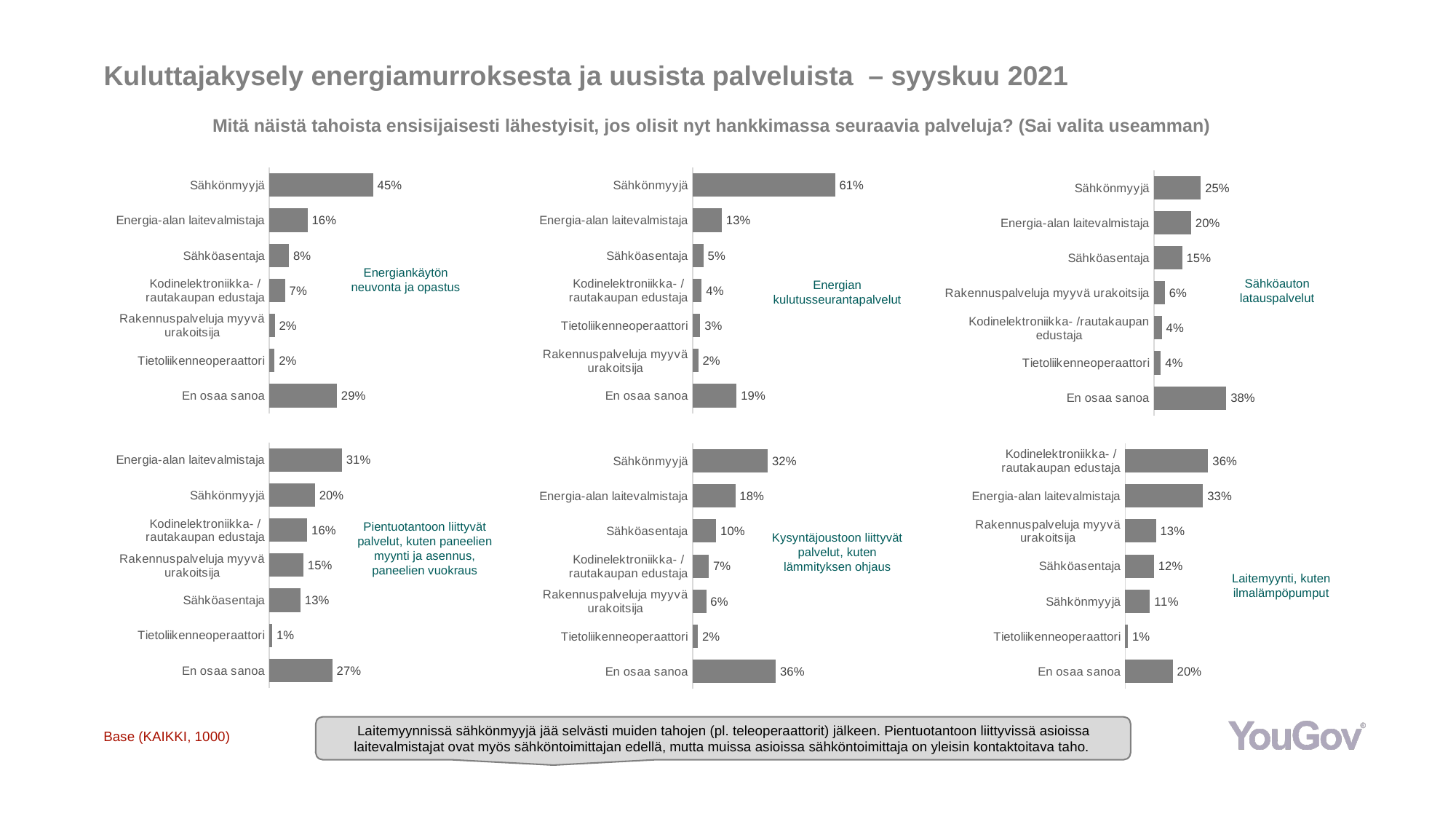
In the 'Energian kulutusseurantapalvelut' chart, which category has the highest value? Sähkönmyyjä How many bar charts are shown on the slide? 6 In the 'Energiankäytön neuvonta ja opastus' chart, what is the difference between Sähkönmyyjä and En osaa sanoa? 16 percentage points In the 'Laitemyynti, kuten ilmalämpöpumput' chart, what is the value for Sähkönmyyjä? 11% In the 'Energiankäytön neuvonta ja opastus' chart, what is the value for Sähkönmyyjä? 45% In the 'Kysyntäjoustoon liittyvät palvelut' chart, which is larger: Sähkönmyyjä or En osaa sanoa? En osaa sanoa In the 'Energian kulutusseurantapalvelut' chart, which category has the lowest value? Rakennuspalveluja myyvä urakoitsija In the 'Laitemyynti, kuten ilmalämpöpumput' chart, which category has the highest value? Kodinelektroniikka- /rautakaupan edustaja How many categories are shown in the 'Sähköauton latauspalvelut' chart? 7 In the 'Sähköauton latauspalvelut' chart, what is the value for En osaa sanoa? 38% In the 'Pientuotantoon liittyvät palvelut' chart, what is the difference between Energia-alan laitevalmistaja and Sähkönmyyjä? 11 percentage points What type of chart is used on this slide? Bar chart